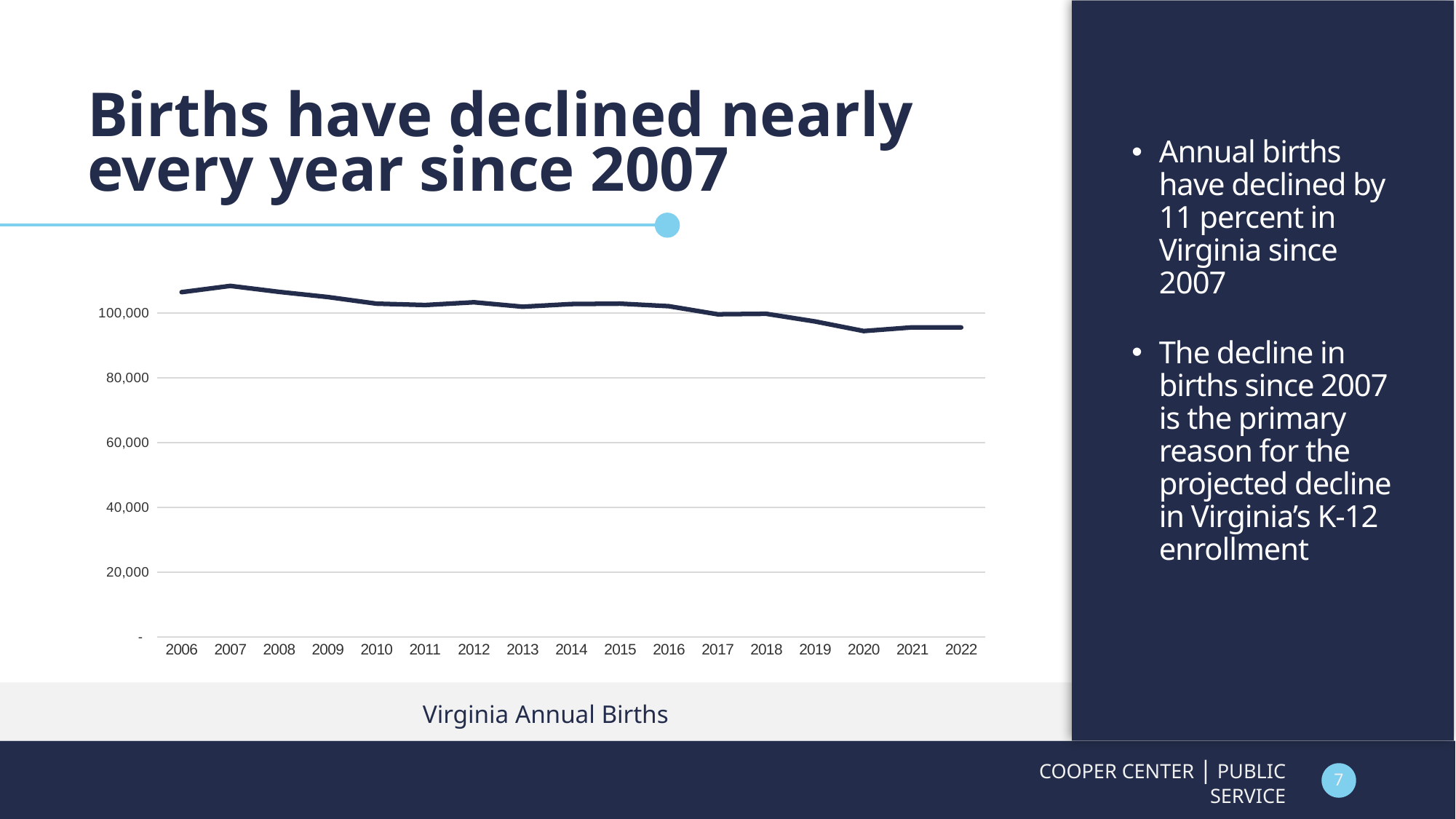
Is the value for 2022 greater or less than 100,000? less Do the values in the chart generally rise or fall from 2007 to 2022? fall Is the value for 2020 greater or less than 100,000? less Is the value for 2007 greater or less than 100,000? greater Which year has the larger value, 2007 or 2020? 2007 What is the first year shown on the x axis of the chart? 2006 How many years are plotted on the x axis of the chart? 17 Which year has the highest value in the chart? 2007 What is the title of the chart? Virginia Annual Births Which year has the lowest value in the chart? 2020 What kind of chart is shown on the slide? line chart Which year has the larger value, 2006 or 2022? 2006